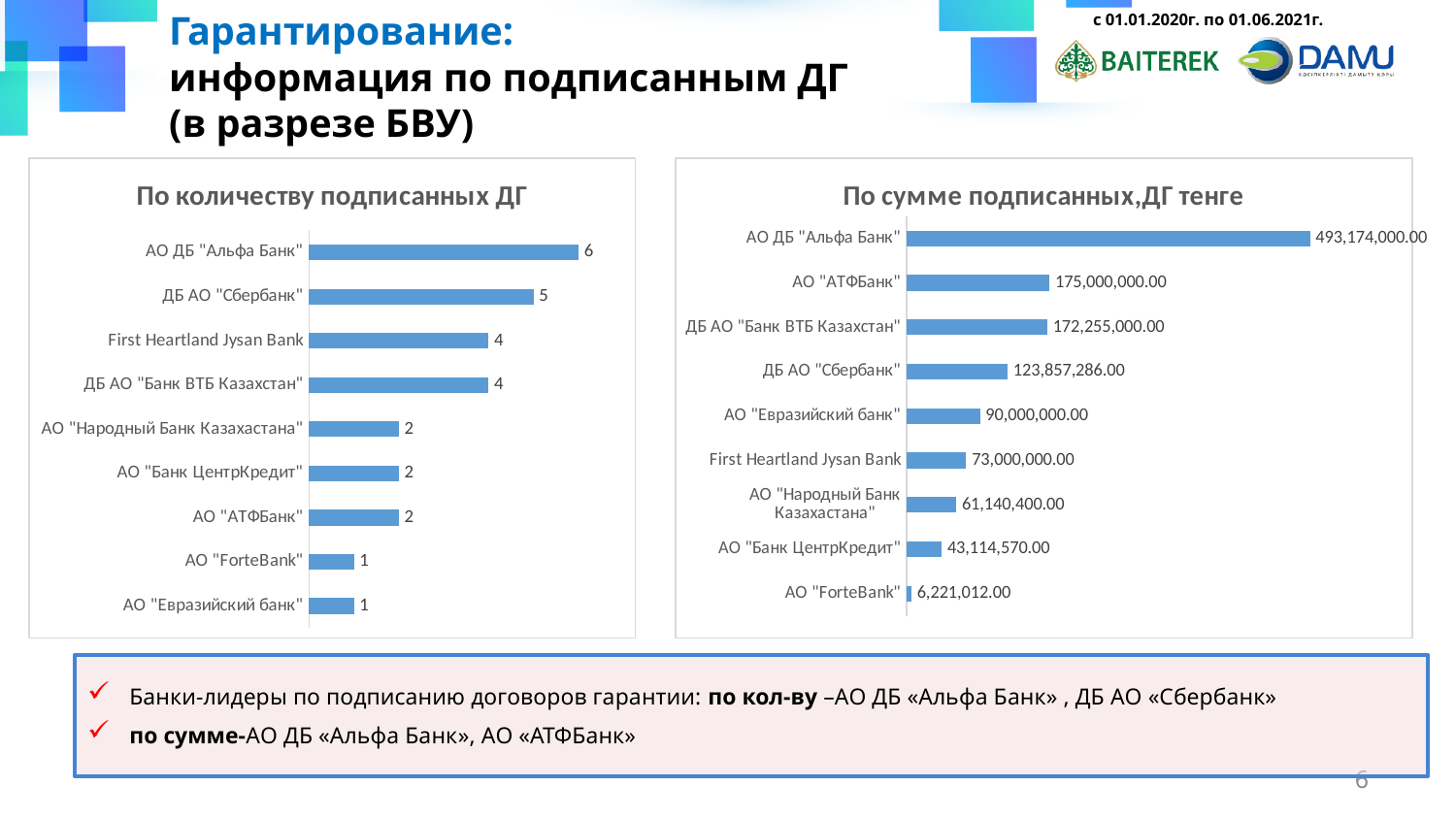
In the chart "По сумме подписанных,ДГ тенге", what is the value for АО "АТФБанк"? 175,000,000.00 In the chart "По сумме подписанных,ДГ тенге", which is larger: ДБ АО "Банк ВТБ Казахстан" or ДБ АО "Сбербанк"? ДБ АО "Банк ВТБ Казахстан" In the chart "По сумме подписанных,ДГ тенге", which bank has the lowest value? АО "ForteBank" In the chart "По количеству подписанных ДГ", which bank has the highest value? АО ДБ "Альфа Банк" In the chart "По сумме подписанных,ДГ тенге", what is the value for АО "Евразийский банк"? 90,000,000.00 In the chart "По количеству подписанных ДГ", what is the value for ДБ АО "Сбербанк"? 5 In the chart "По количеству подписанных ДГ", what is the difference between АО ДБ "Альфа Банк" and First Heartland Jysan Bank? 2 In the chart "По сумме подписанных,ДГ тенге", what is the difference between АО "АТФБанк" and ДБ АО "Банк ВТБ Казахстан"? 2,745,000.00 What type of chart is "По сумме подписанных,ДГ тенге"? Bar chart In the chart "По сумме подписанных,ДГ тенге", what is the value for АО "Банк ЦентрКредит"? 43,114,570.00 In the chart "По количеству подписанных ДГ", what is the value for АО "ForteBank"? 1 In the chart "По количеству подписанных ДГ", how many banks are shown? 9